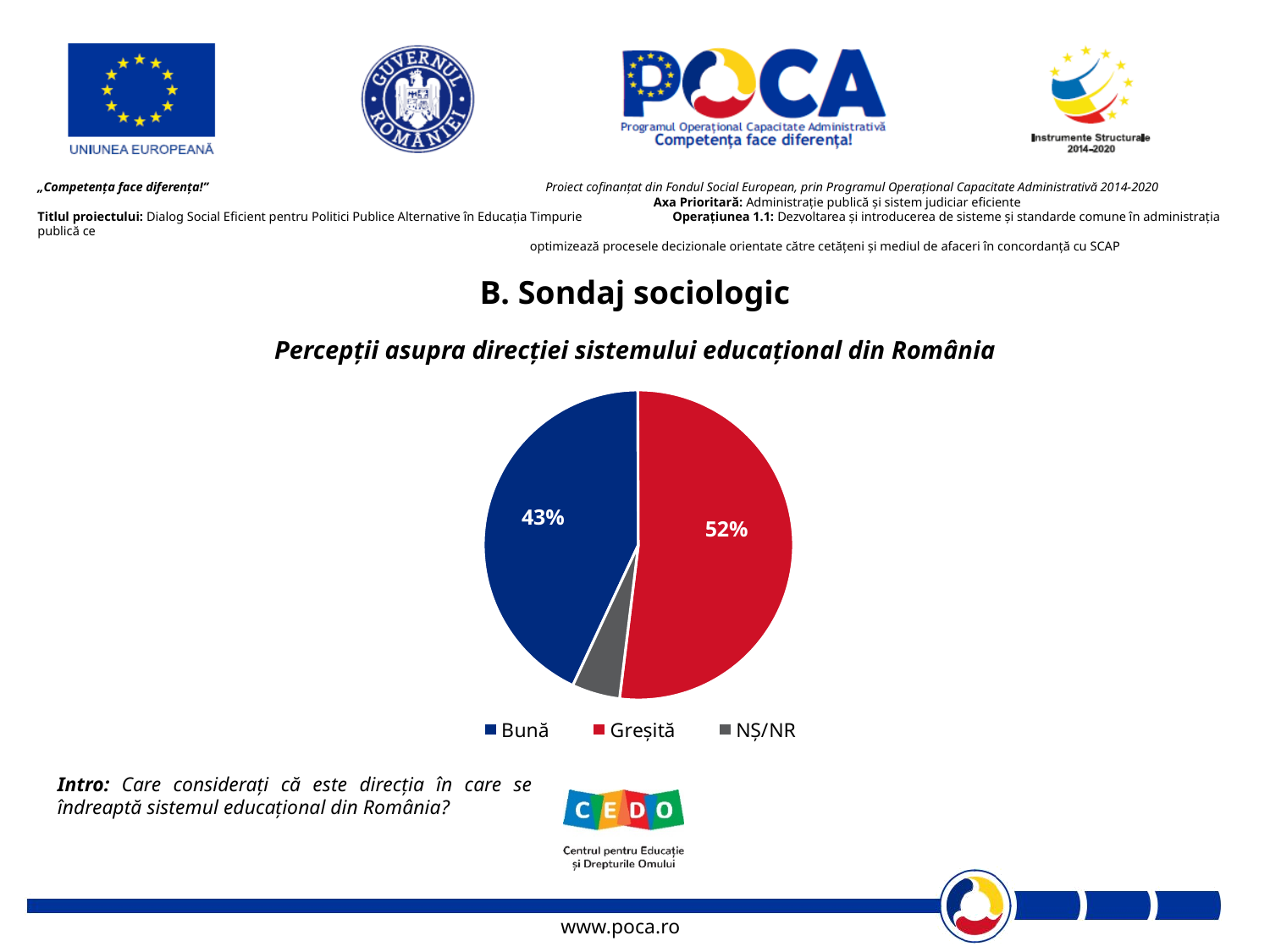
How many categories does the pie chart show? 3 What percentage of respondents said the direction of the education system is "Bună"? 43% Which category has the largest slice of the pie? Greșită What share of the pie does the "Greșită" slice represent? 52% How many entries does the legend list? 3 Which category has the smallest slice of the pie? NȘ/NR What percentage of respondents said the direction of the education system is "Greșită"? 52% Which is larger, the share for "Bună" or the share for "Greșită"? Greșită By how many percentage points does "Greșită" exceed "Bună"? 9 percentage points What kind of chart is shown on the slide? Pie chart What is the title of the chart? Percepții asupra direcției sistemului educațional din România What colour is the "Bună" slice in the pie chart? Blue